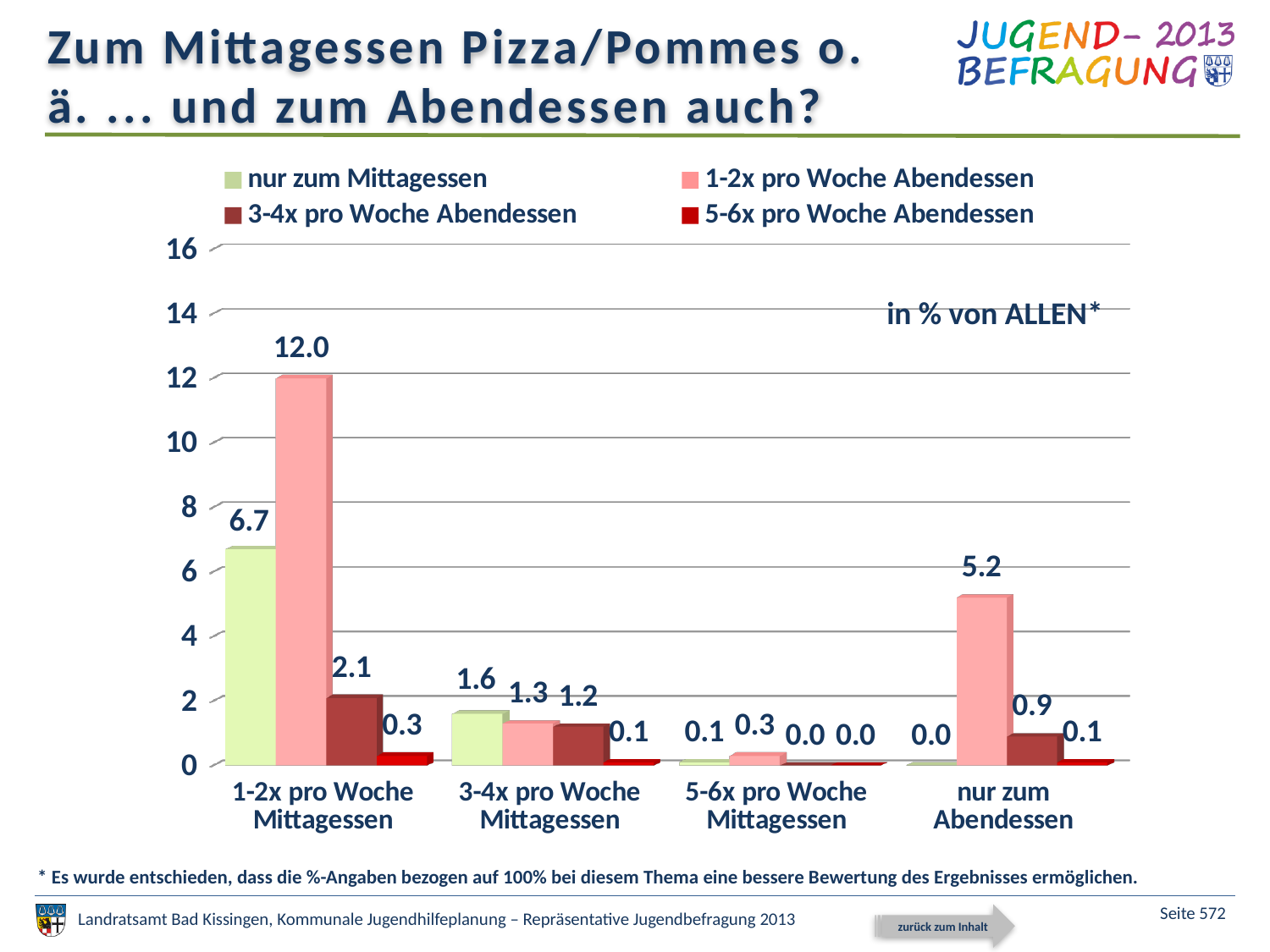
What is the value for '1-2x pro Woche Abendessen' in the 'nur zum Abendessen' category? 5.2 What kind of chart is shown on the slide? bar chart Which category has the lowest value for the 'nur zum Mittagessen' series? nur zum Abendessen What unit note is printed inside the chart area? in % von ALLEN* How many series does the legend list? 4 What is the difference between the '1-2x pro Woche Abendessen' value and the 'nur zum Mittagessen' value in the '1-2x pro Woche Mittagessen' category? 5.3 In the '3-4x pro Woche Mittagessen' category, which is larger: 'nur zum Mittagessen' or '1-2x pro Woche Abendessen'? nur zum Mittagessen What is the value for '1-2x pro Woche Abendessen' in the '1-2x pro Woche Mittagessen' category? 12.0 How many categories are shown on the x axis? 4 Which category has the highest value for the '1-2x pro Woche Abendessen' series? 1-2x pro Woche Mittagessen What is the value for '3-4x pro Woche Abendessen' in the '3-4x pro Woche Mittagessen' category? 1.2 What is the value for 'nur zum Mittagessen' in the '1-2x pro Woche Mittagessen' category? 6.7